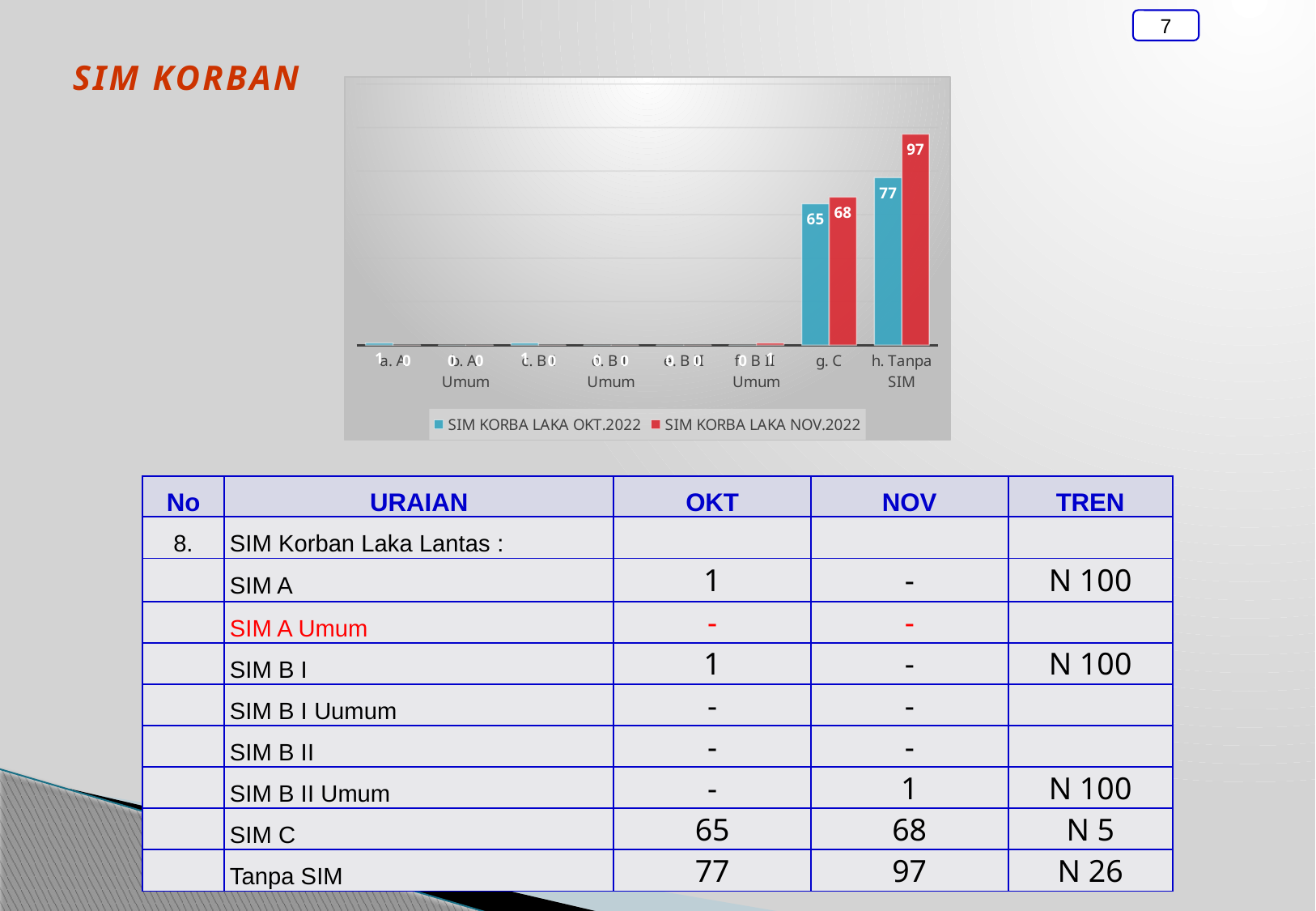
What is the value for h. Tanpa SIM in the SIM KORBA LAKA OKT.2022 series? 77 What is the value for h. Tanpa SIM in the SIM KORBA LAKA NOV.2022 series? 97 Which is larger for h. Tanpa SIM: the OKT.2022 value or the NOV.2022 value? NOV.2022 Which category has the highest value in the SIM KORBA LAKA NOV.2022 series? h. Tanpa SIM What is the value for g. C in the SIM KORBA LAKA NOV.2022 series? 68 How many series does the chart legend list? 2 What is the difference between the NOV.2022 and OKT.2022 values for g. C? 3 What is the value for g. C in the SIM KORBA LAKA OKT.2022 series? 65 What is the difference between the NOV.2022 and OKT.2022 values for h. Tanpa SIM? 20 What kind of chart is shown on the slide? bar chart How many categories are shown on the x axis of the chart? 8 Which colour represents the SIM KORBA LAKA NOV.2022 series in the chart? red